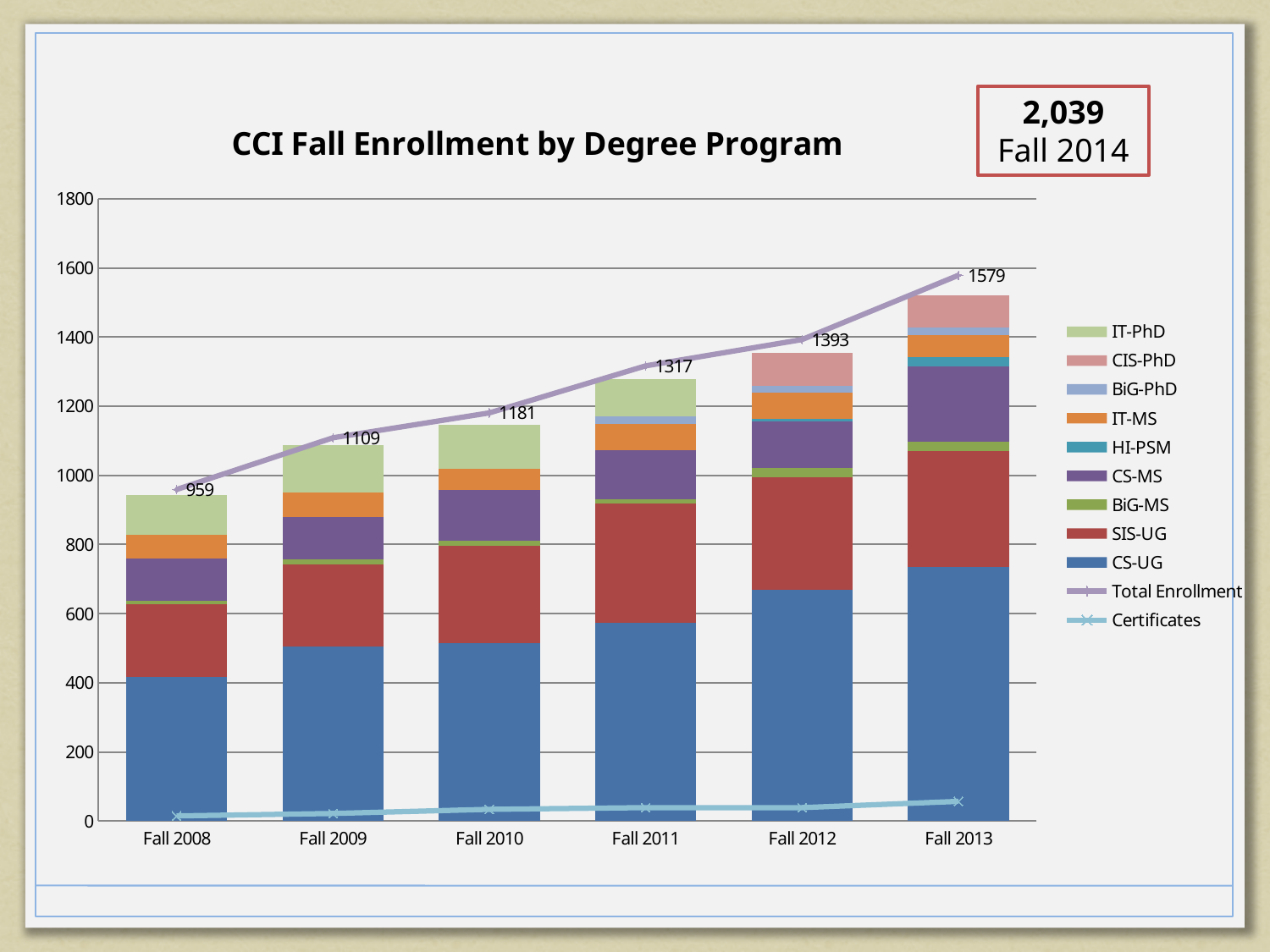
How many entries does the legend list? 11 Is the Total Enrollment higher in Fall 2012 or Fall 2011? Fall 2012 What is the Total Enrollment value for Fall 2011? 1317 What is the Total Enrollment value for Fall 2013? 1579 Which fall term has the lowest Total Enrollment? Fall 2008 What is the difference in Total Enrollment between Fall 2010 and Fall 2009? 72 Which fall term has the highest Total Enrollment? Fall 2013 What is the difference in Total Enrollment between Fall 2013 and Fall 2012? 186 Does Total Enrollment rise or fall from Fall 2008 to Fall 2013? rise How many fall terms are shown on the x axis? 6 What is the Total Enrollment value for Fall 2008? 959 Is the CS-UG value for Fall 2013 greater or less than 600? greater